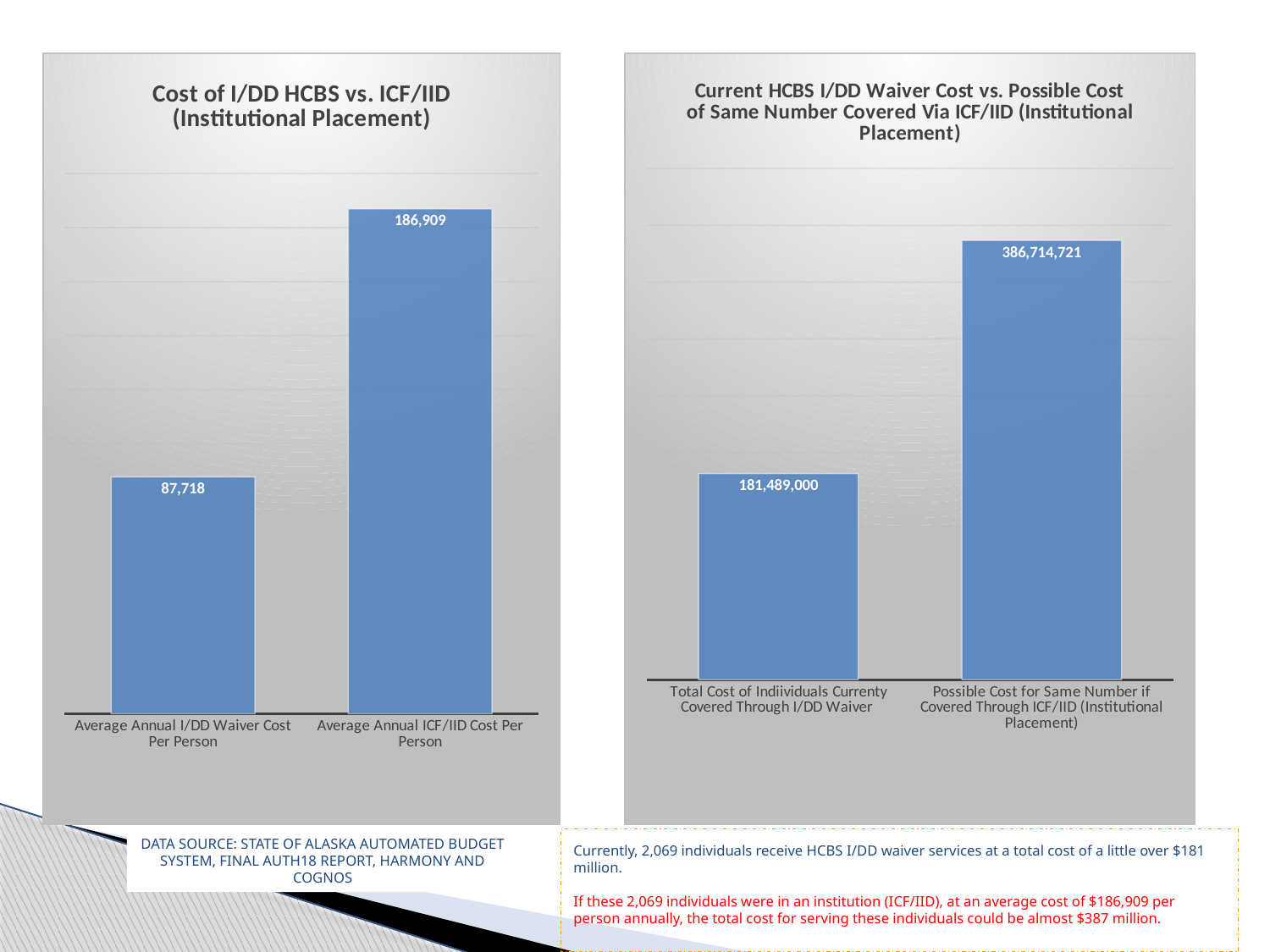
How many bars are shown in the left chart? 2 In the right chart, what is the difference between the Possible Cost if Covered Through ICF/IID and the Total Cost Currently Covered Through I/DD Waiver? 205,225,721 What type of chart is the right chart? bar chart In the left chart, what is the difference between the Average Annual ICF/IID Cost Per Person and the Average Annual I/DD Waiver Cost Per Person? 99,191 In the right chart, what is the Possible Cost for Same Number if Covered Through ICF/IID (Institutional Placement)? 386,714,721 In the left chart, what is the Average Annual ICF/IID Cost Per Person? 186,909 In the right chart, which category has the lower value? Total Cost of Individuals Currently Covered Through I/DD Waiver In the left chart, what is the Average Annual I/DD Waiver Cost Per Person? 87,718 In the right chart, is the value for the I/DD Waiver total cost larger or smaller than the value for the ICF/IID possible cost? smaller What is the title of the left chart? Cost of I/DD HCBS vs. ICF/IID (Institutional Placement) In the left chart, which category has the higher value? Average Annual ICF/IID Cost Per Person In the right chart, what is the Total Cost of Individuals Currently Covered Through I/DD Waiver? 181,489,000